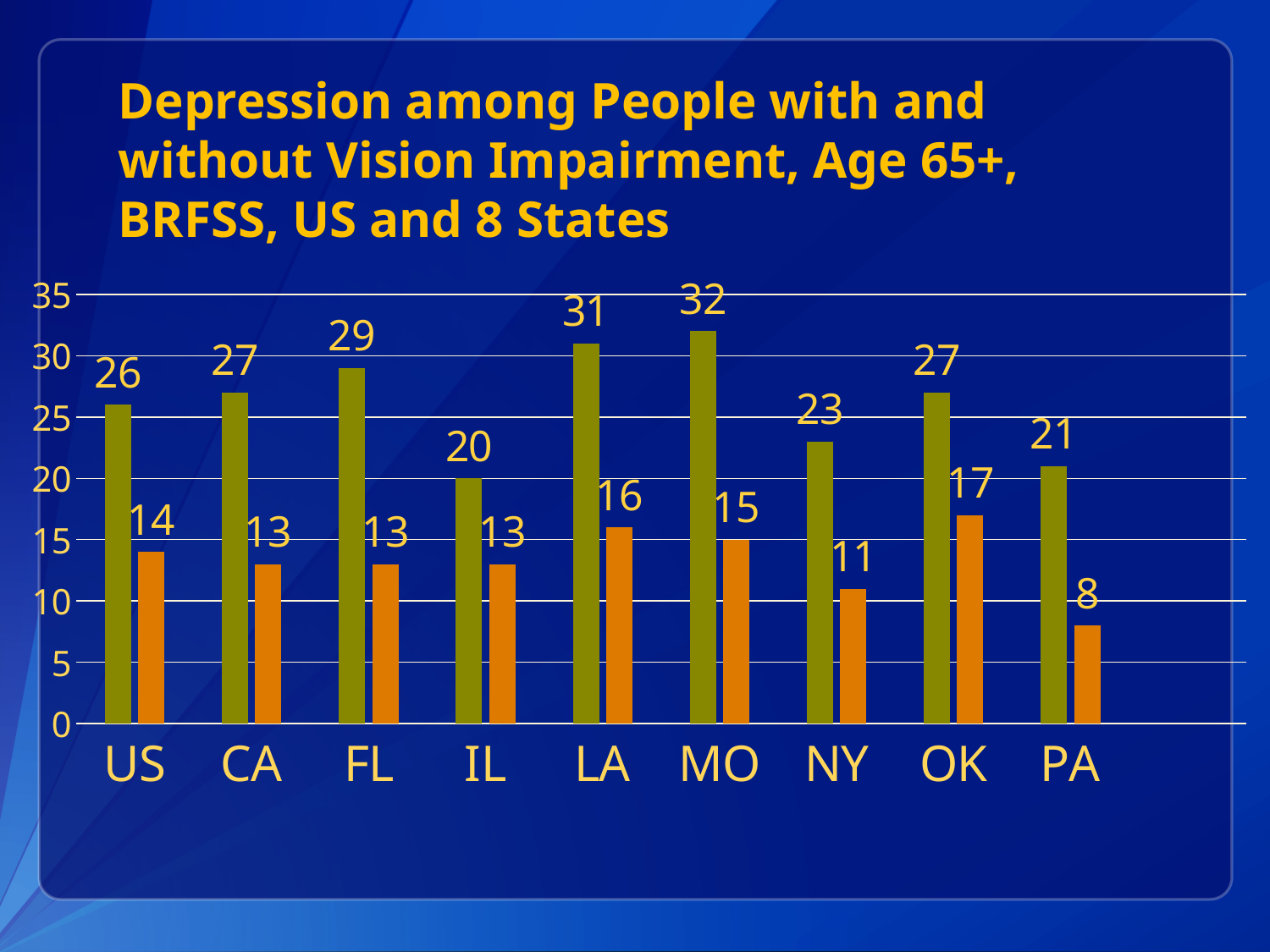
Which is larger, the green bar for FL or the green bar for NY? FL Which category has the highest green bar? MO What is the value of the green bar for MO? 32 What is the value of the green bar for IL? 20 What is the value of the orange bar for PA? 8 What is the title of the chart? Depression among People with and without Vision Impairment, Age 65+, BRFSS, US and 8 States How many categories are shown on the x axis? 9 Which category has the lowest orange bar? PA What is the difference between the green and orange bars for LA? 15 What is the value of the orange bar for OK? 17 What kind of chart is shown on the slide? bar chart Which category has the lowest green bar? IL